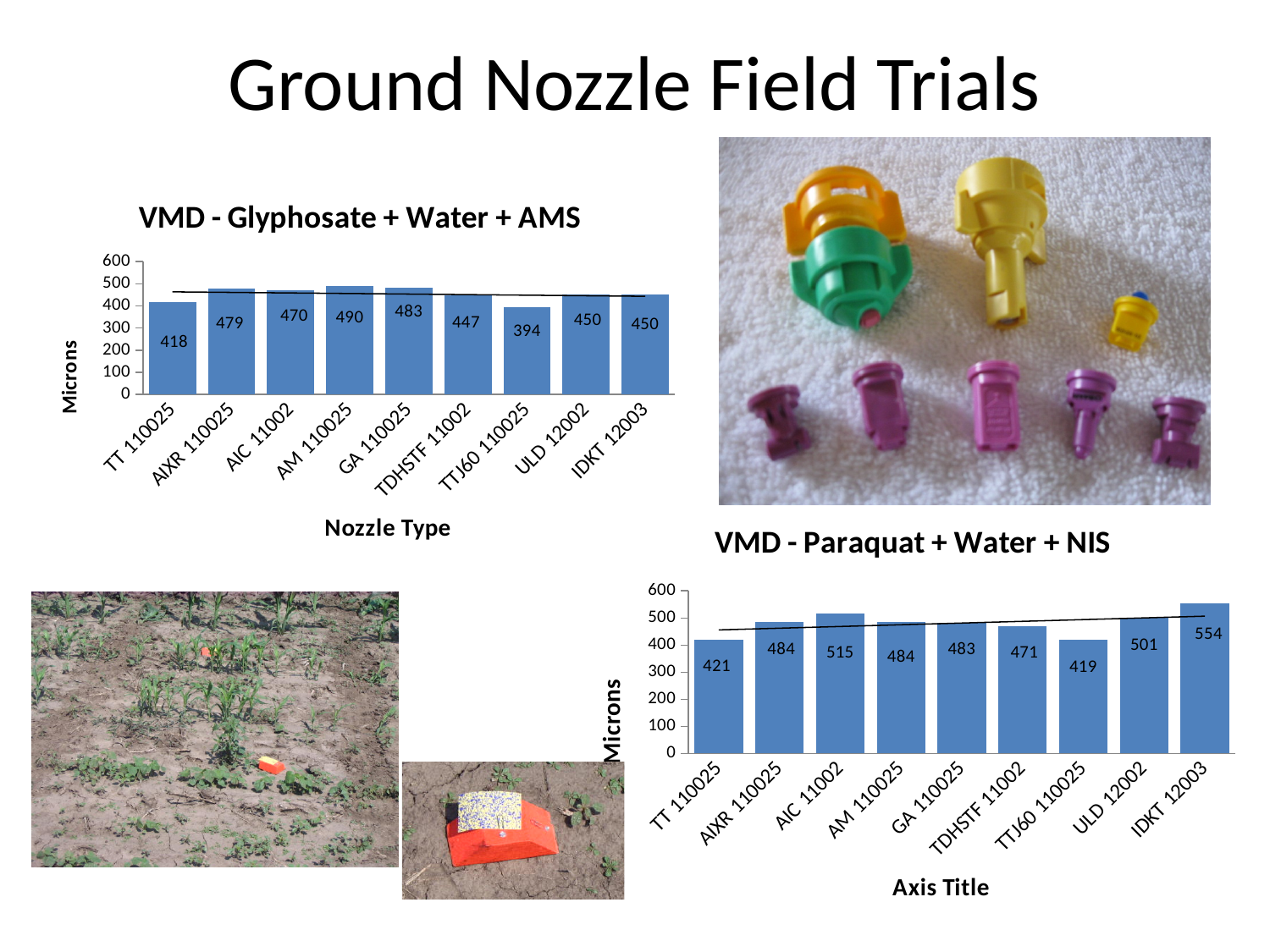
In the VMD - Glyphosate + Water + AMS chart, which nozzle type has the highest value? AM 110025 In the VMD - Paraquat + Water + NIS chart, what is the difference between the values for IDKT 12003 and TTJ60 110025? 135 In the VMD - Paraquat + Water + NIS chart, is the value for TT 110025 greater or less than 500? less In the VMD - Paraquat + Water + NIS chart, which is larger, the value for ULD 12002 or the value for TDHSTF 11002? ULD 12002 In the VMD - Glyphosate + Water + AMS chart, how many nozzle types are shown? 9 What is the y-axis label of the VMD - Glyphosate + Water + AMS chart? Microns In the VMD - Paraquat + Water + NIS chart, which nozzle type has the highest value? IDKT 12003 In the VMD - Glyphosate + Water + AMS chart, what is the difference between the values for AIXR 110025 and TT 110025? 61 What kind of chart is the VMD - Paraquat + Water + NIS chart? Bar chart In the VMD - Paraquat + Water + NIS chart, what is the value for AIC 11002? 515 In the VMD - Glyphosate + Water + AMS chart, which nozzle type has the lowest value? TTJ60 110025 In the VMD - Glyphosate + Water + AMS chart, what is the value for AM 110025? 490